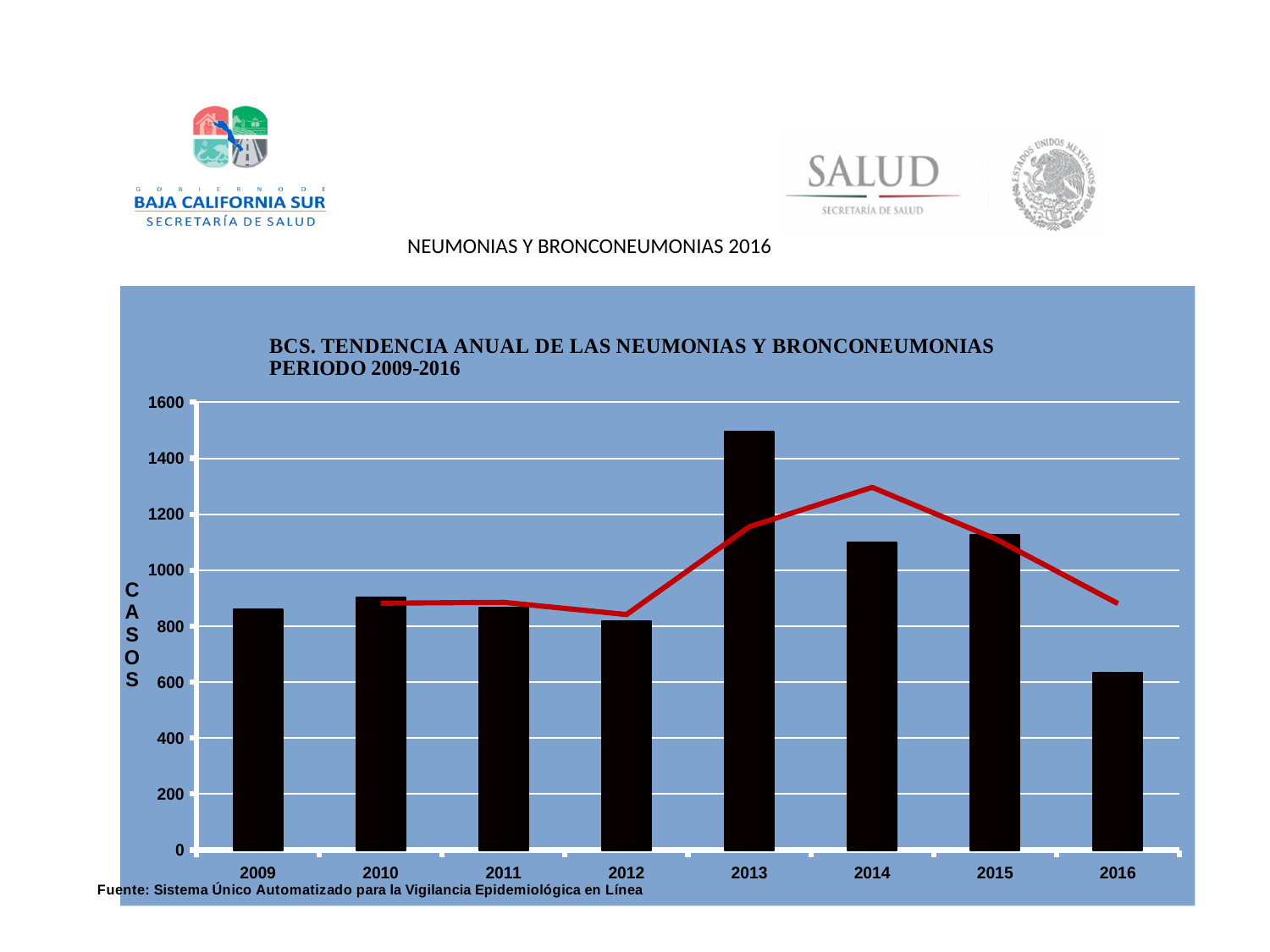
Is the value for 2013 greater or less than 1400? greater Which year has the lowest bar in the chart? 2016 What kind of chart is used to show the annual cases? Bar chart Which bar is taller, 2012 or 2016? 2012 How many years are shown on the x axis of the chart? 8 Is the value for 2016 greater or less than 800? less Do the bars rise or fall from 2015 to 2016? Fall Which year has the highest bar in the chart? 2013 What label is shown on the vertical axis of the chart? CASOS Is the value for 2014 greater or less than 1000? greater Which bar is taller, 2013 or 2014? 2013